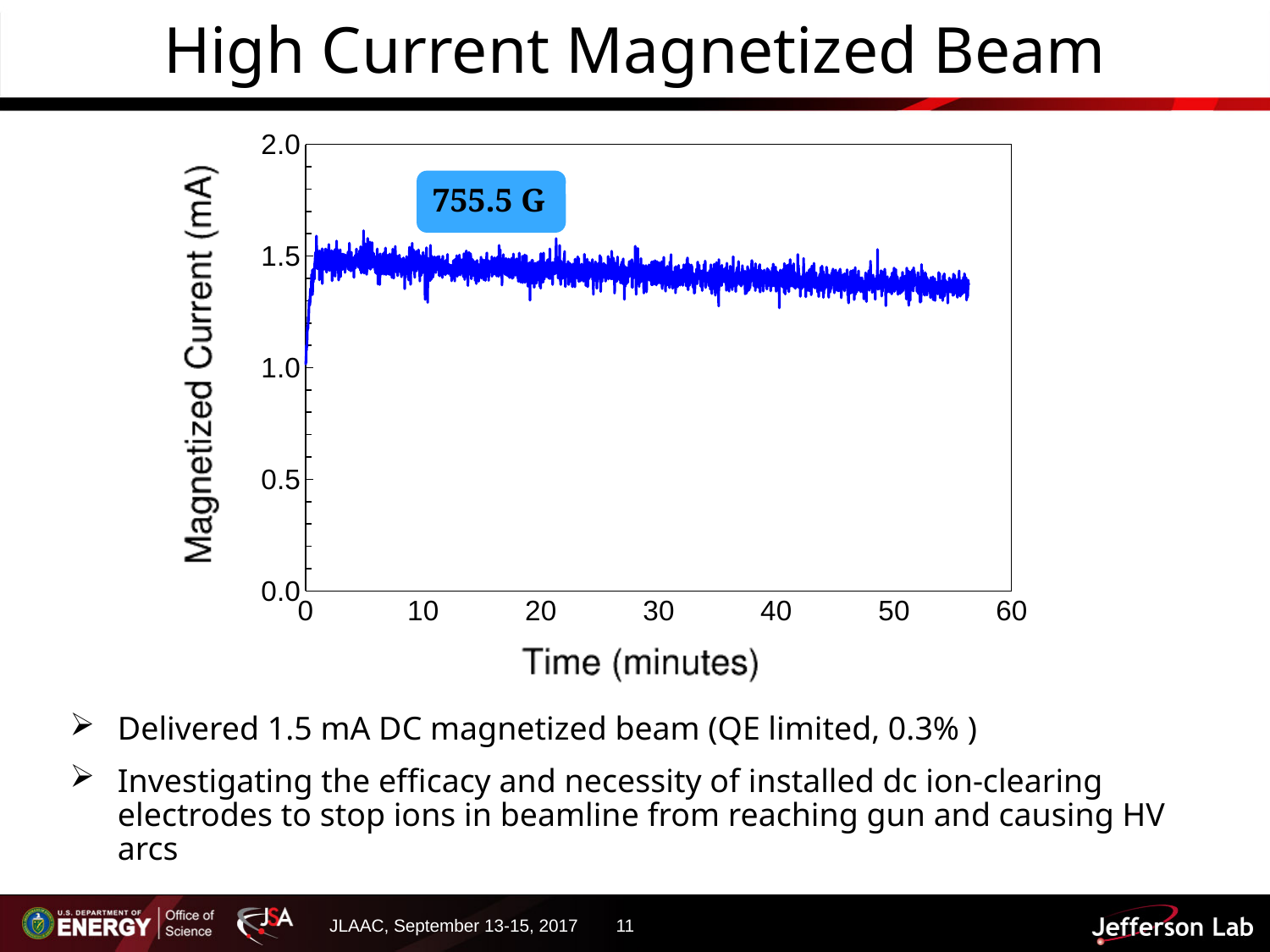
What is the highest value shown on the y axis of the chart? 2.0 Is the magnetized current at 50 minutes greater or less than 0.5 mA? greater Is the magnetized current at 20 minutes greater or less than 2.0 mA? less Does the magnetized current rise or fall between 10 minutes and 50 minutes? fall Is the magnetized current at 30 minutes greater or less than 1.0 mA? greater What kind of chart is shown on the slide? line chart How many data series are plotted on the chart? 1 Is the magnetized current at 5 minutes larger or smaller than at 55 minutes? larger What magnetic field value is annotated on the chart? 755.5 G